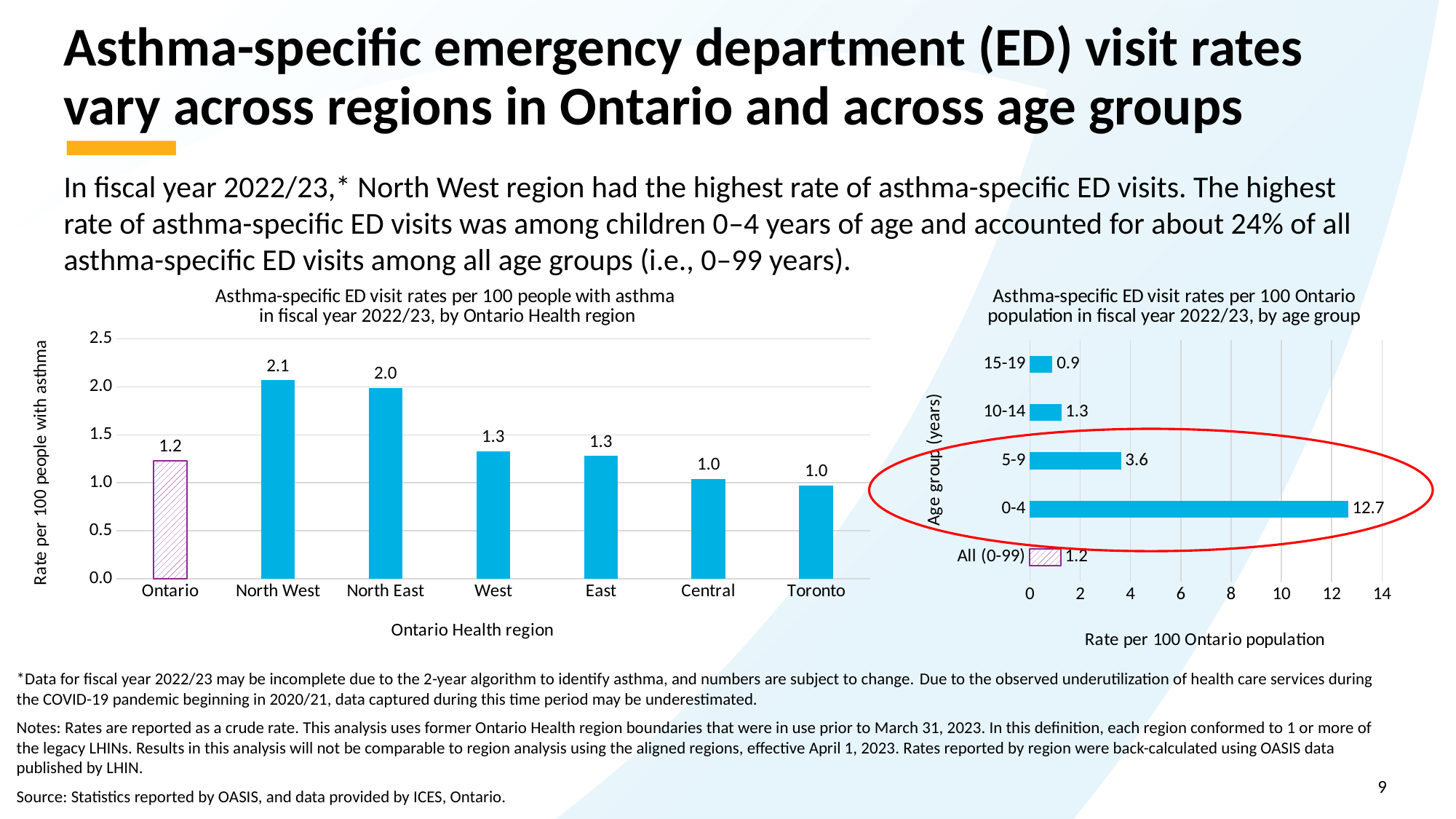
In the chart by Ontario Health region, which region has the highest rate? North West In the chart by Ontario Health region, what is the rate for Ontario overall? 1.2 In the chart by age group, which age group has the lowest rate? 15-19 In the chart by Ontario Health region, what is the difference between the North West and Toronto rates? 1.1 In the chart by age group, what is the rate for the 0-4 age group? 12.7 In the chart by age group, what is the difference between the 0-4 and 5-9 rates? 9.1 In the chart by age group, what is the label of the horizontal axis? Rate per 100 Ontario population In the chart by Ontario Health region, what is the rate for North West? 2.1 In the chart by Ontario Health region, which is larger, the rate for North East or the rate for West? North East In the chart by Ontario Health region, how many categories are shown on the x axis? 7 In the chart by age group, how many age group categories are shown? 5 In the chart by Ontario Health region, what kind of chart is it? Bar chart